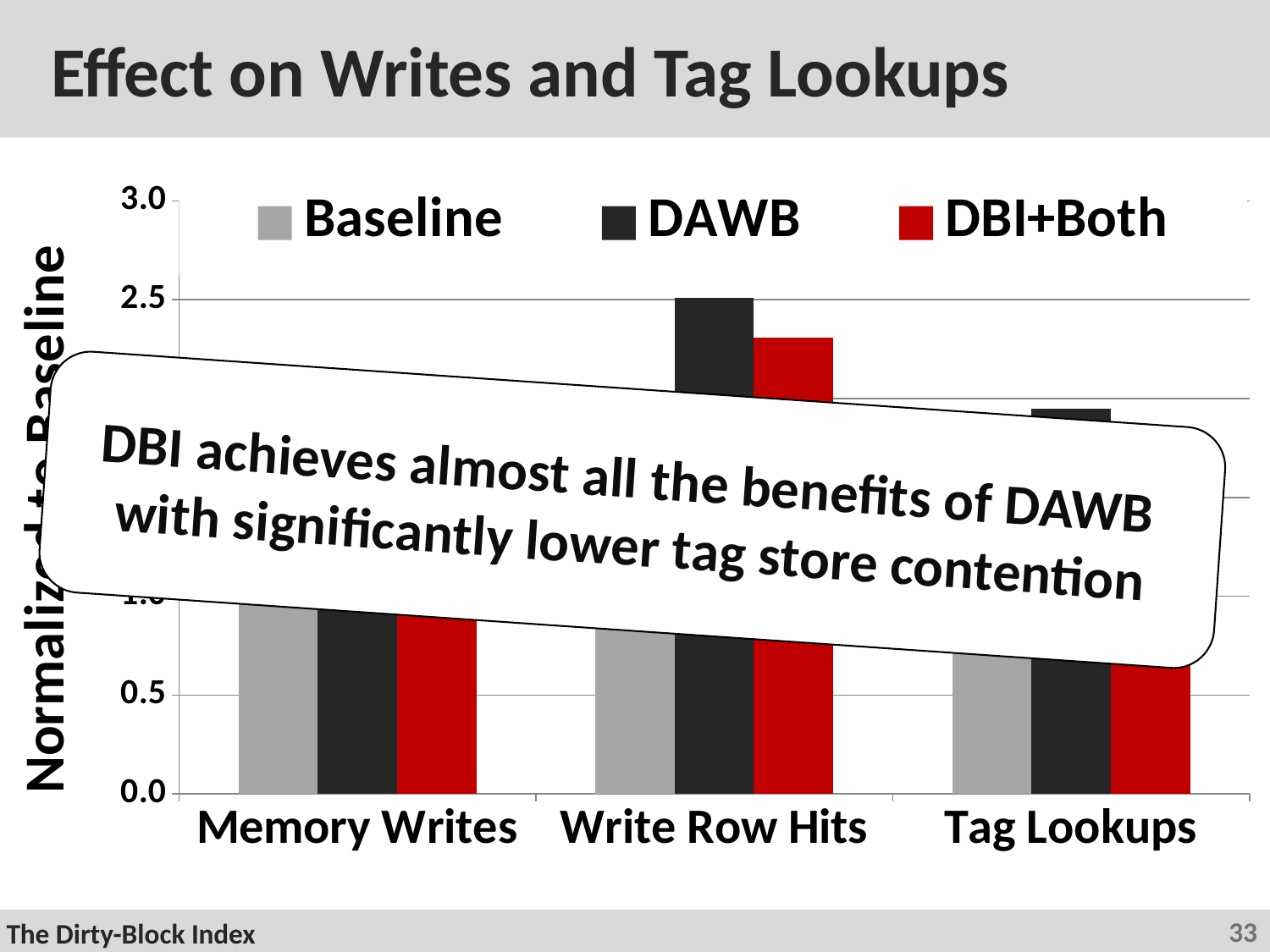
What are the three series named in the chart's legend? Baseline, DAWB, DBI+Both How many series does the chart's legend list? 3 For which category is the DAWB bar the highest? Write Row Hits How many categories are shown on the x axis of the chart? 3 Is the DAWB value for Write Row Hits greater or less than 2.0? greater What is the title of the chart's y axis? Normalized to Baseline Which is larger: the DAWB bar for Write Row Hits or the DAWB bar for Tag Lookups? Write Row Hits For Write Row Hits, which is larger: the DAWB bar or the DBI+Both bar? DAWB Is the DBI+Both value for Write Row Hits greater or less than 2.0? greater Is the DAWB value for Tag Lookups greater or less than 1.5? greater What kind of chart is shown on the slide? bar chart